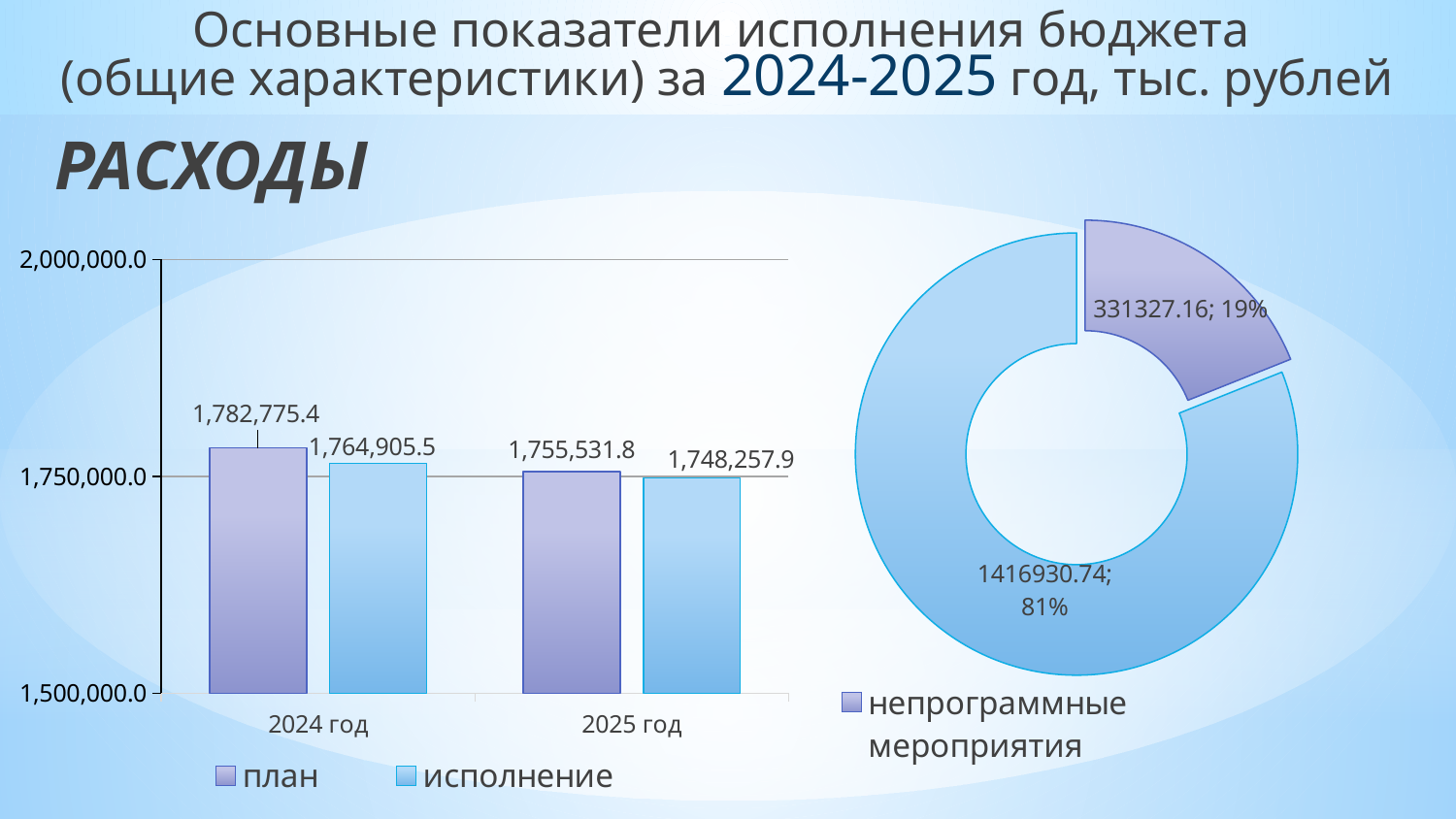
In the bar chart on the left, what is the difference between план for 2024 год and план for 2025 год? 27,243.6 In the bar chart on the left, which bar has the lowest value? исполнение, 2025 год In the bar chart on the left, what is the value of исполнение for 2024 год? 1,764,905.5 In the bar chart on the left, which bar has the highest value? план, 2024 год In the bar chart on the left, does the план value rise or fall from 2024 год to 2025 год? fall In the bar chart on the left, what is the difference between план and исполнение for 2024 год? 17,869.9 In the bar chart on the left, which is larger: план for 2025 год or исполнение for 2024 год? исполнение for 2024 год In the bar chart on the left, how many series does the legend list? 2 In the doughnut chart on the right, what share of the total does непрограммные мероприятия represent? 19% In the bar chart on the left, what is the value of план for 2024 год? 1,782,775.4 In the doughnut chart on the right, what is the value of the larger slice? 1416930.74 In the bar chart on the left, what is the value of исполнение for 2025 год? 1,748,257.9